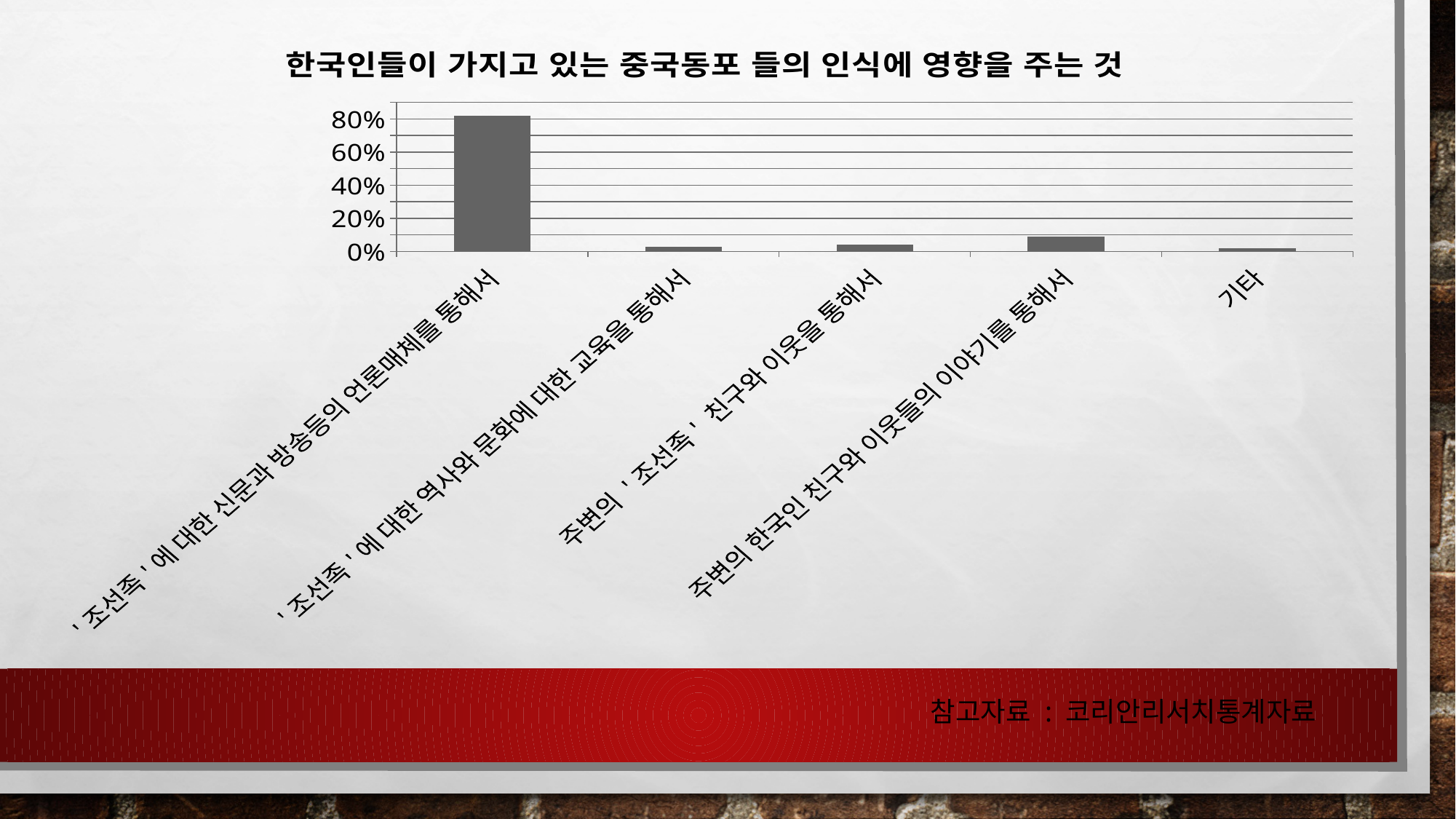
Is the value for '조선족'에 대한 역사와 문화에 대한 교육을 통해서 greater or less than 20%? less Which is larger: the value for 주변의 '조선족' 친구와 이웃을 통해서 or the value for 주변의 한국인 친구와 이웃들의 이야기를 통해서? 주변의 한국인 친구와 이웃들의 이야기를 통해서 What kind of chart is shown on the slide? bar chart What is the title of the chart? 한국인들이 가지고 있는 중국동포 들의 인식에 영향을 주는 것 Is the value for '조선족'에 대한 신문과 방송등의 언론매체를 통해서 greater or less than 60%? greater Is the value for 주변의 한국인 친구와 이웃들의 이야기를 통해서 greater or less than 20%? less Which is larger: the value for '조선족'에 대한 신문과 방송등의 언론매체를 통해서 or the value for 주변의 한국인 친구와 이웃들의 이야기를 통해서? '조선족'에 대한 신문과 방송등의 언론매체를 통해서 Which category has the highest value in the chart? '조선족'에 대한 신문과 방송등의 언론매체를 통해서 How many categories are plotted in the chart? 5 What is the highest value shown on the chart's vertical axis? 80%